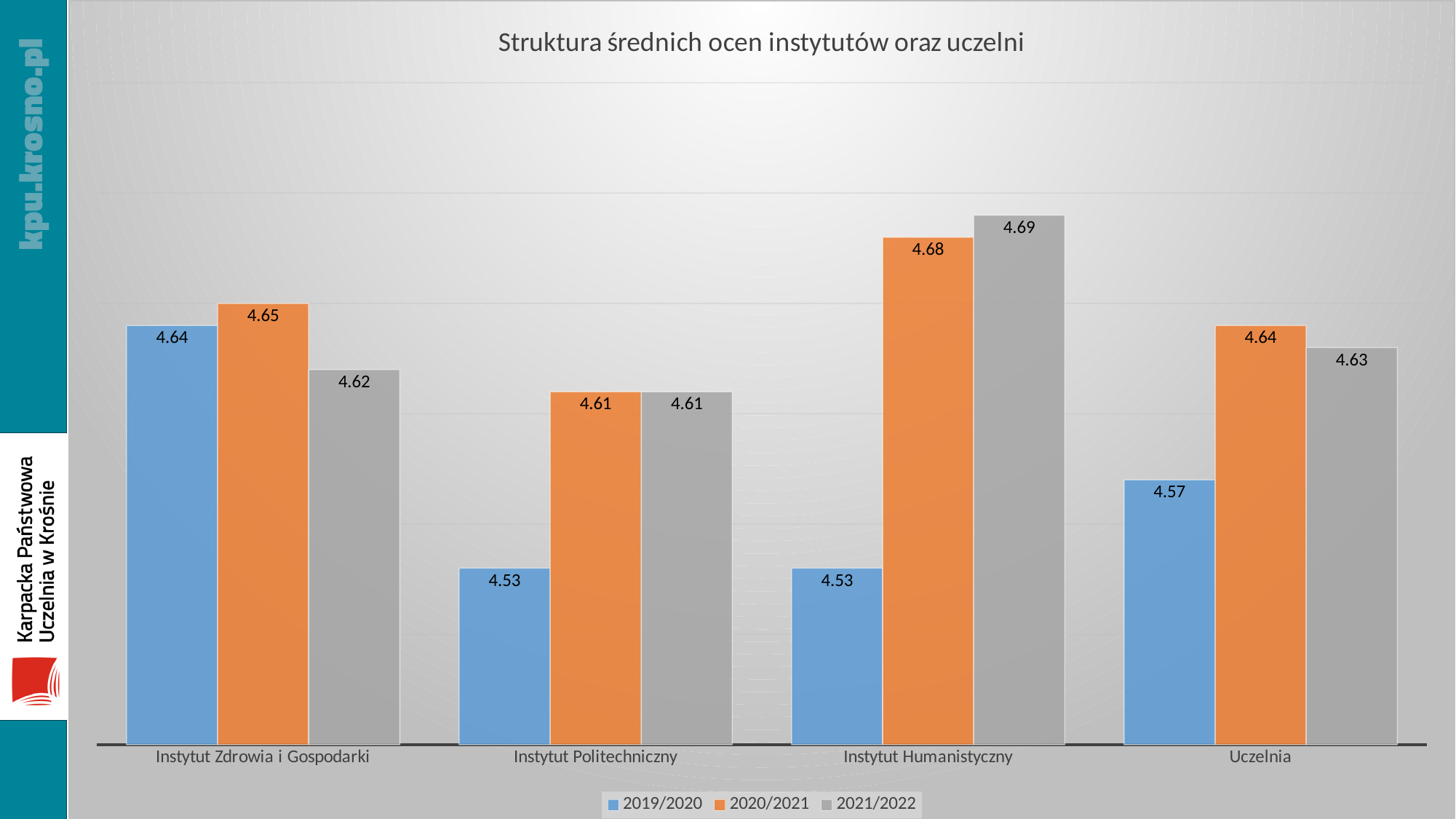
What is the title of the chart? Struktura średnich ocen instytutów oraz uczelni What is the value for Instytut Politechniczny in the 2020/2021 series? 4.61 Which category has the highest value in the 2021/2022 series? Instytut Humanistyczny What is the value for Instytut Humanistyczny in the 2021/2022 series? 4.69 Which category has the lowest value in the 2020/2021 series? Instytut Politechniczny How many categories are shown on the x axis? 4 What is the value for Uczelnia in the 2019/2020 series? 4.57 How many series does the legend list? 3 What is the difference between the 2021/2022 and 2019/2020 values for Instytut Humanistyczny? 0.16 Which series is shown in orange in the legend? 2020/2021 Which is larger for Instytut Zdrowia i Gospodarki: the 2020/2021 value or the 2021/2022 value? 2020/2021 What kind of chart is shown on the slide? Bar chart